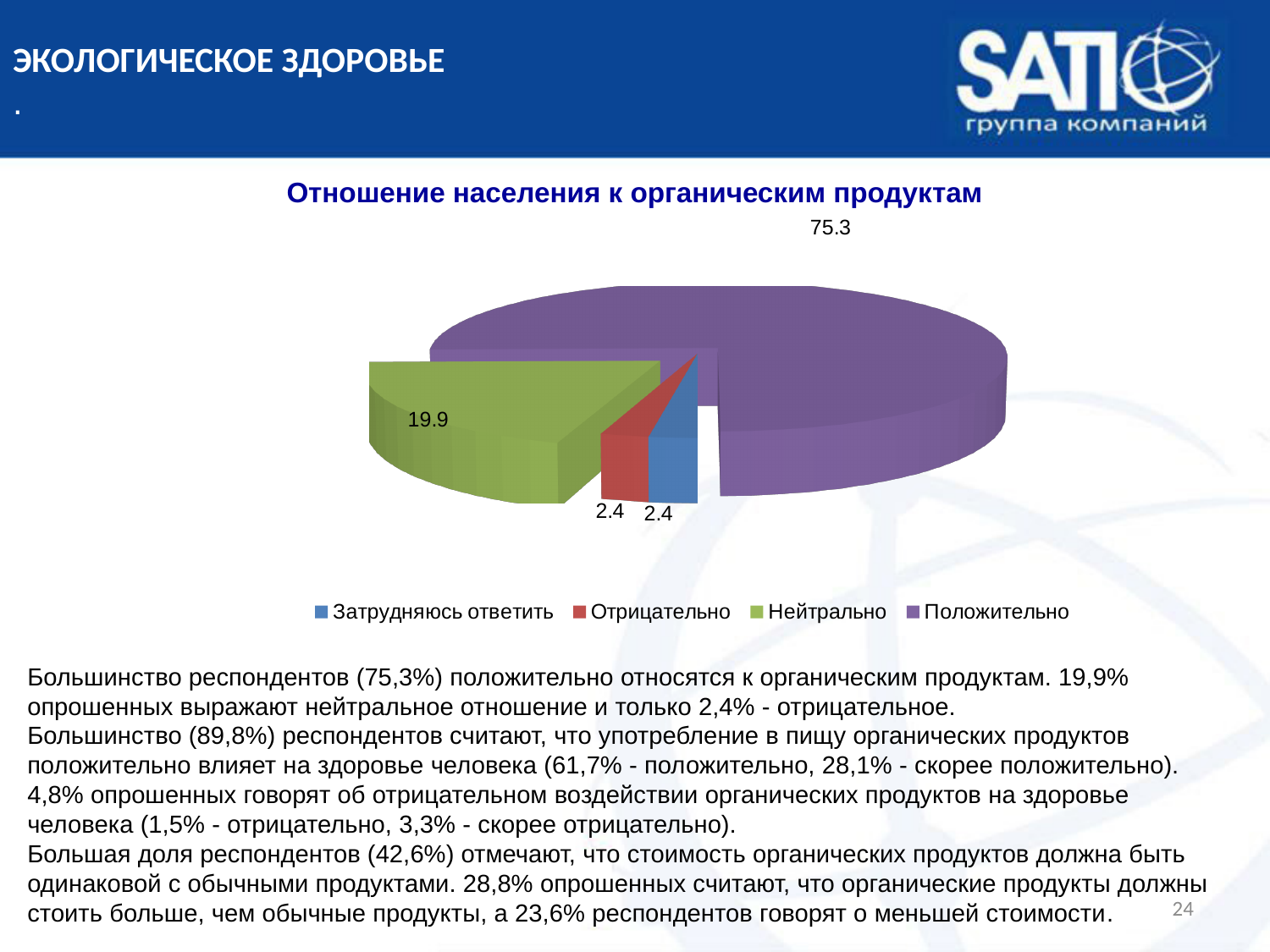
Which is larger, the value for Нейтрально or the value for Положительно? Положительно How many categories does the pie chart show? 4 What is the difference between the values for Положительно and Нейтрально? 55.4 What is the value shown for the Нейтрально slice? 19.9 How many entries does the legend list? 4 What kind of chart is shown on the slide? Pie chart What is the value shown for the Затрудняюсь ответить slice? 2.4 What is the value shown for the Положительно slice? 75.3 Which category has the largest slice of the pie? Положительно What is the title of the chart? Отношение населения к органическим продуктам What is the value shown for the Отрицательно slice? 2.4 What colour is the Положительно slice? Purple